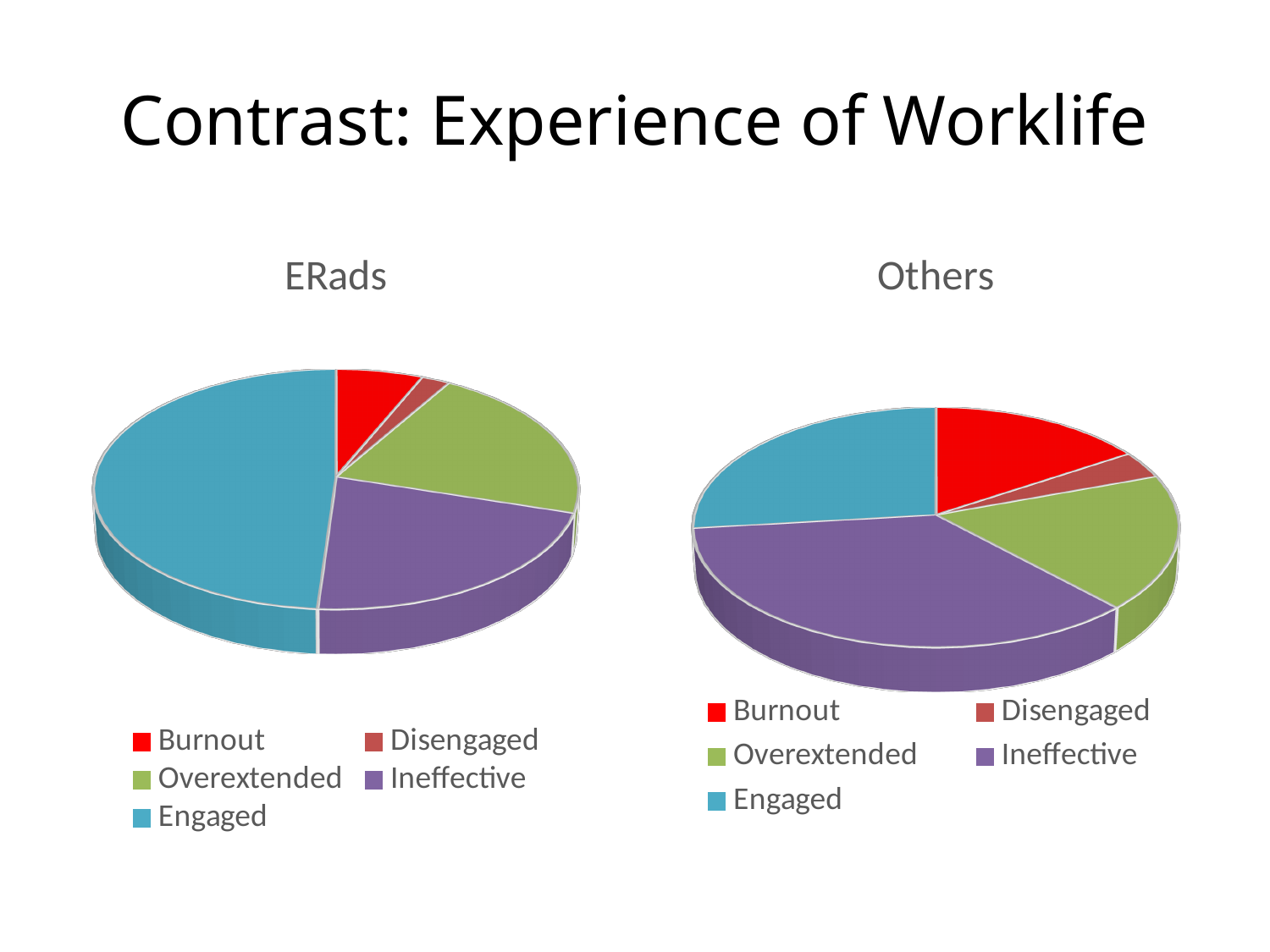
How many categories does the legend of the Others chart list? 5 In the Others chart, which category has the smallest slice? Disengaged What colour represents the Ineffective category in both charts? purple In the Others chart, which category has the largest slice? Ineffective In the Others chart, which slice is larger, Engaged or Burnout? Engaged In the ERads chart, which category has the smallest slice? Disengaged How many slices does the ERads pie chart have? 5 In the ERads chart, which slice is larger, Engaged or Burnout? Engaged In the ERads chart, which category has the largest slice? Engaged What kind of chart is the Others chart? pie chart In the Others chart, which slice is larger, Ineffective or Overextended? Ineffective What kind of chart is the ERads chart? pie chart